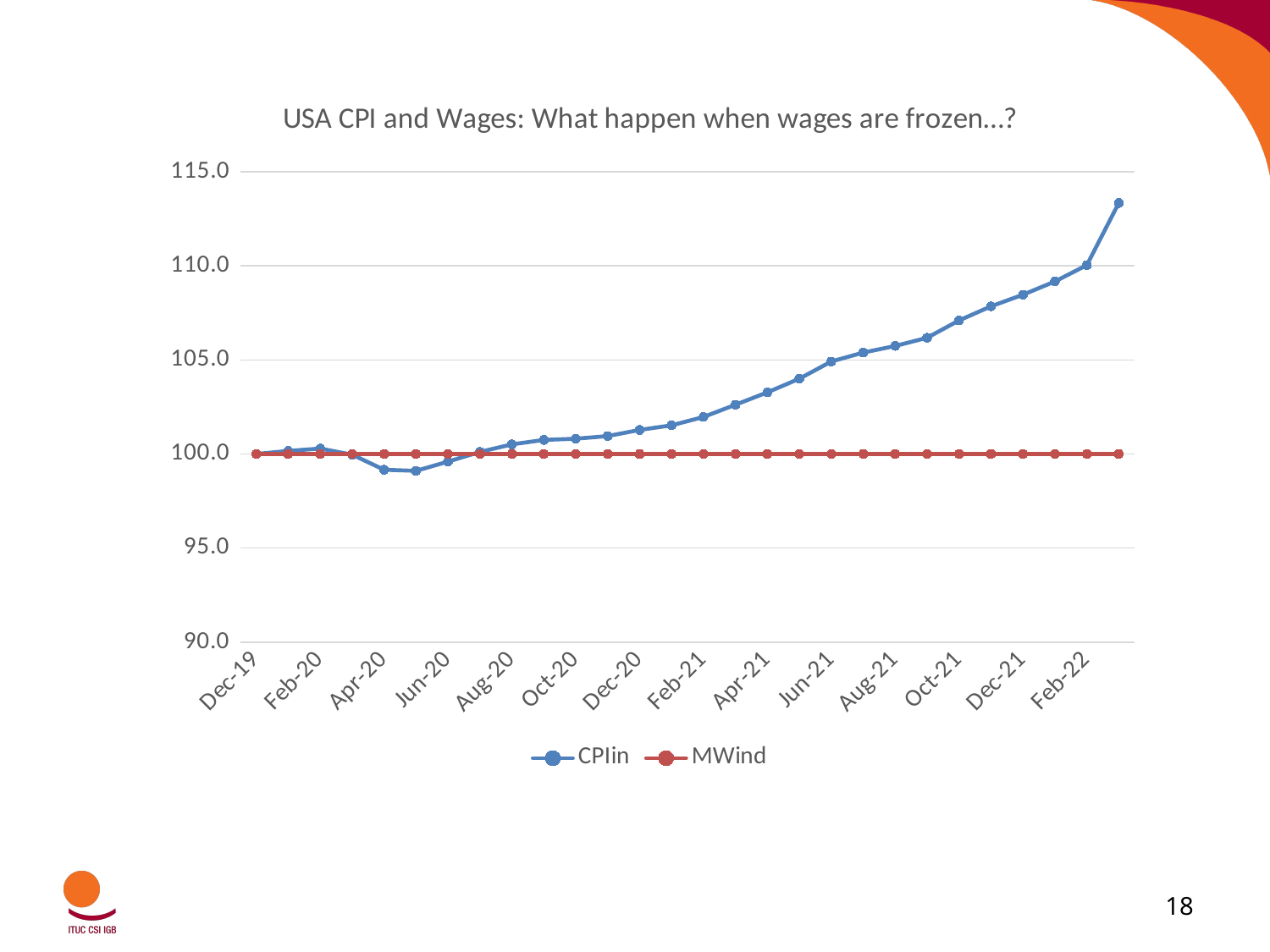
How many month labels are shown on the x axis? 14 How many series does the legend list? 2 What is the value of MWind at Jun-20? 100.0 Is the value of CPIin at Apr-21 greater or less than 105.0? less Is the value of CPIin at Dec-21 greater or less than 105.0? greater Is the value of MWind at Aug-21 greater or less than 105.0? less What is the title of the chart? USA CPI and Wages: What happen when wages are frozen…? What is the value of MWind at Dec-21? 100.0 Does the CPIin series rise or fall overall from Dec-19 to the end of the chart? rise At Feb-22, which series has the larger value, CPIin or MWind? CPIin What kind of chart is shown on the slide? line chart What are the two series named in the legend? CPIin and MWind